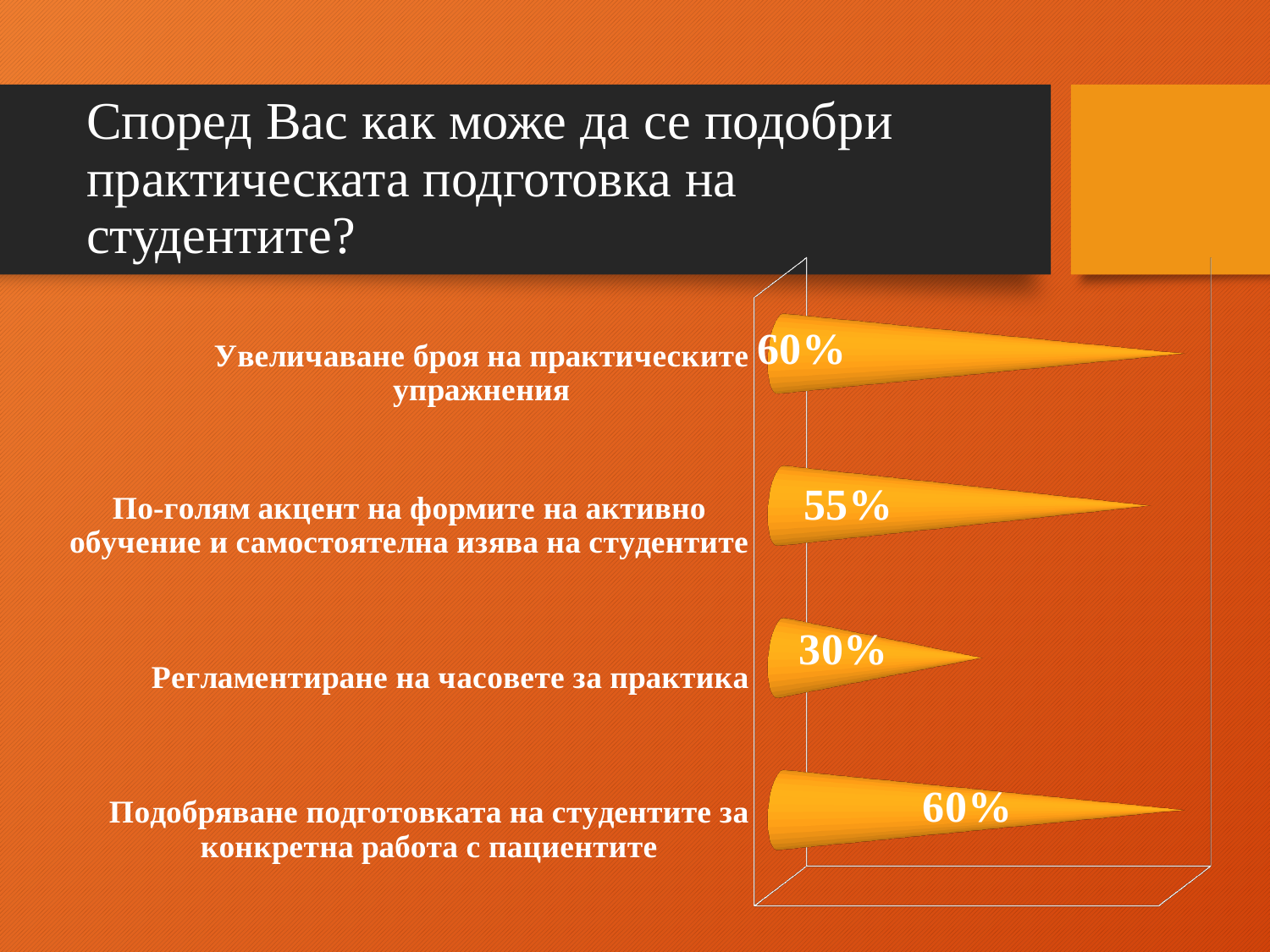
What kind of chart is shown on the slide? Bar chart What is the value for "По-голям акцент на формите на активно обучение и самостоятелна изява на студентите"? 55% What is the title of the slide? Според Вас как може да се подобри практическата подготовка на студентите? Which is larger: the value for "По-голям акцент на формите на активно обучение и самостоятелна изява на студентите" or the value for "Регламентиране на часовете за практика"? По-голям акцент на формите на активно обучение и самостоятелна изява на студентите What is the difference between the values for "Подобряване подготовката на студентите за конкретна работа с пациентите" and "По-голям акцент на формите на активно обучение и самостоятелна изява на студентите"? 5 percentage points How many categories are shown in the chart? 4 What is the difference between the values for "По-голям акцент на формите на активно обучение и самостоятелна изява на студентите" and "Регламентиране на часовете за практика"? 25 percentage points What is the value for "Увеличаване броя на практическите упражнения"? 60% Which category has the lowest value? Регламентиране на часовете за практика What is the value for "Регламентиране на часовете за практика"? 30% What is the difference between the values for "Увеличаване броя на практическите упражнения" and "Регламентиране на часовете за практика"? 30 percentage points What is the value for "Подобряване подготовката на студентите за конкретна работа с пациентите"? 60%